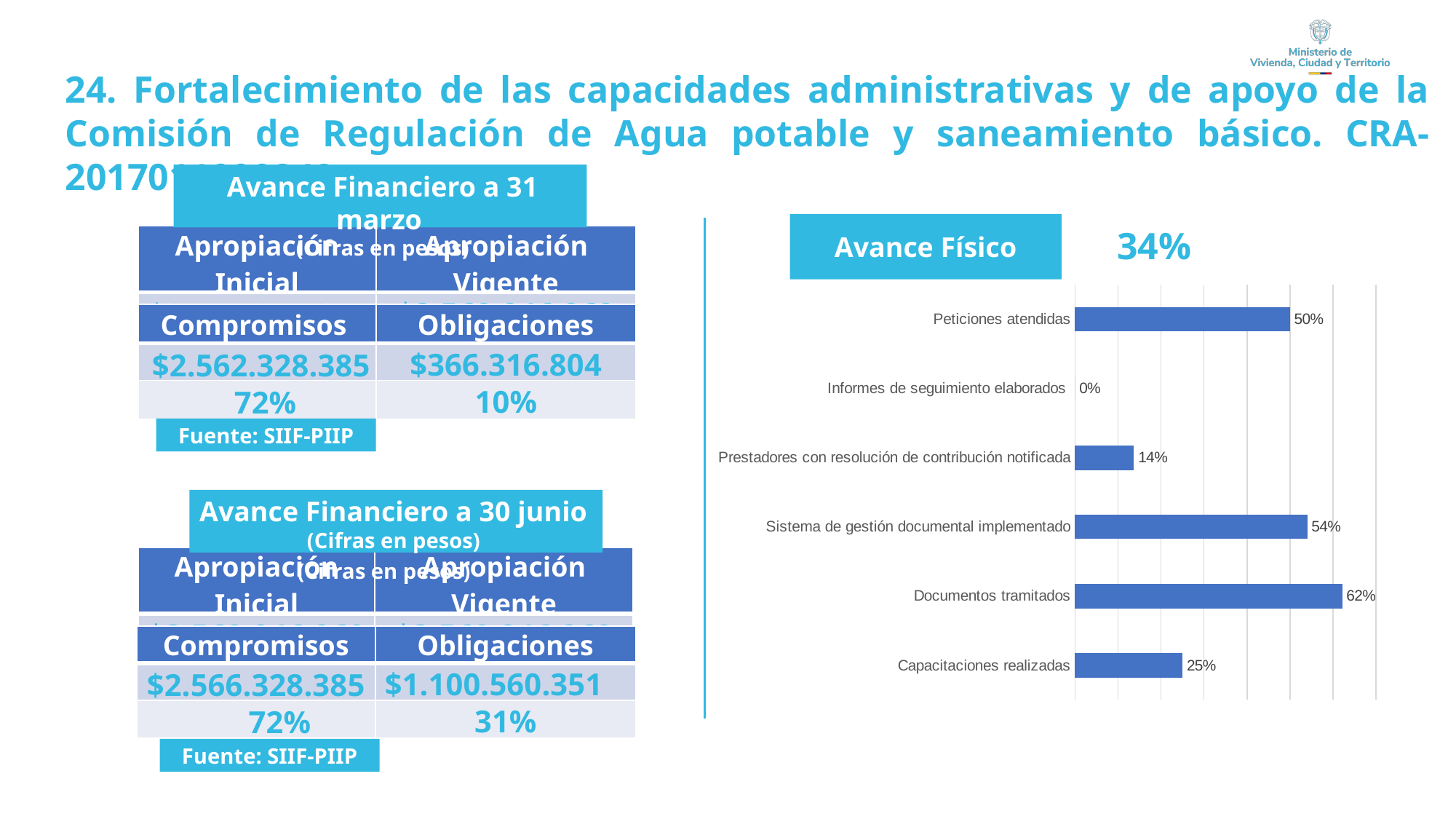
What is the value for Capacitaciones realizadas in the bar chart? 25% What is the difference between the values for Documentos tramitados and Sistema de gestión documental implementado? 8% What is the value for Peticiones atendidas in the bar chart? 50% Which category has the highest value in the bar chart? Documentos tramitados What is the difference between the values for Sistema de gestión documental implementado and Prestadores con resolución de contribución notificada? 40% What is the value for Prestadores con resolución de contribución notificada in the bar chart? 14% What is the value for Informes de seguimiento elaborados in the bar chart? 0% What kind of chart is shown on the right side of the slide? Bar chart Which is larger in the bar chart: Peticiones atendidas or Capacitaciones realizadas? Peticiones atendidas How many categories are shown in the bar chart? 6 What is the value for Documentos tramitados in the bar chart? 62% Which category has the lowest value in the bar chart? Informes de seguimiento elaborados